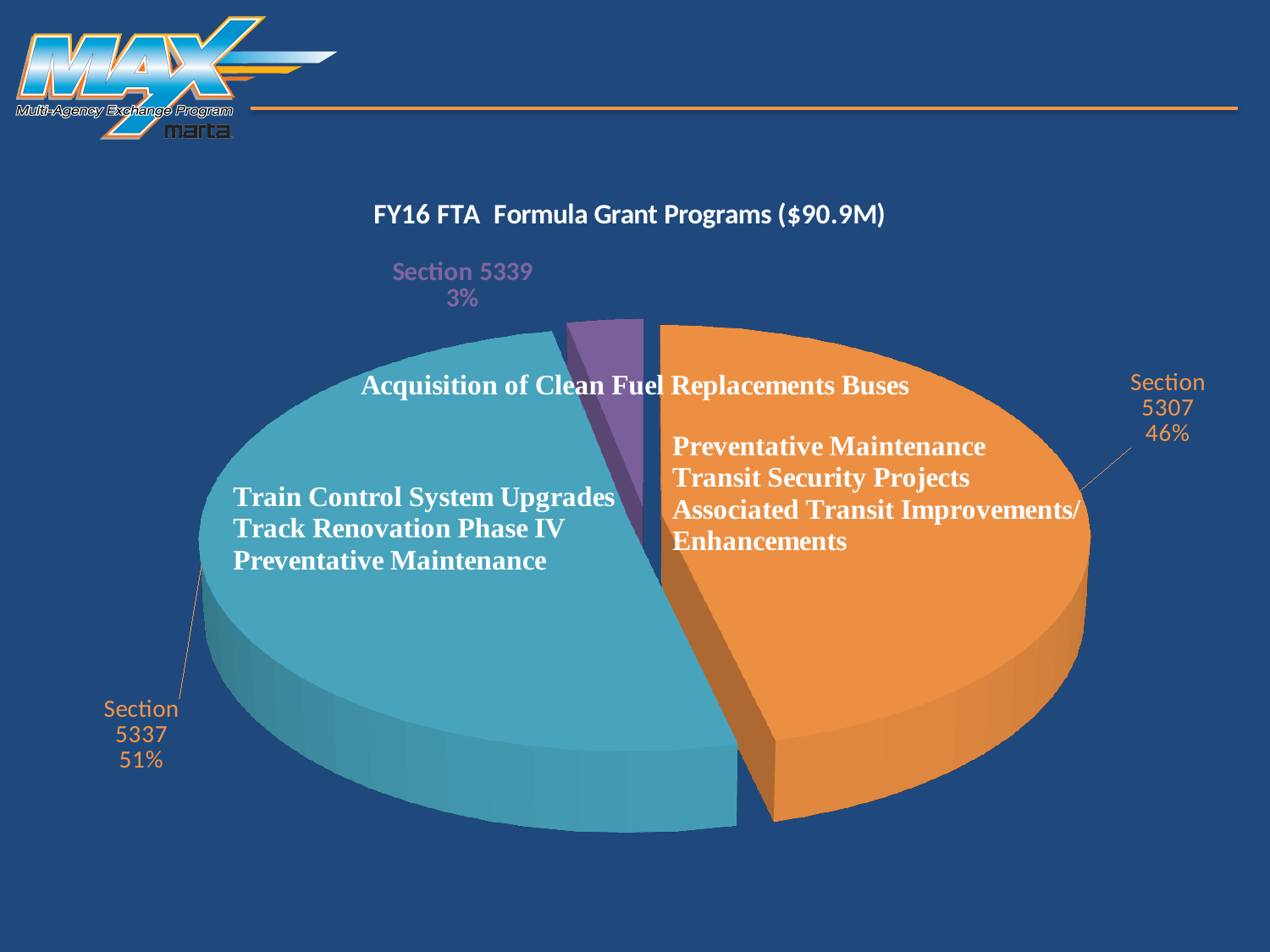
What is the difference in percentage points between Section 5307 and Section 5339? 43 What share of the pie does Section 5337 represent? 51% How many slices does the pie chart have? 3 Which section has the largest share of the pie? Section 5337 What is the title of the chart? FY16 FTA Formula Grant Programs ($90.9M) Which is larger, the share for Section 5307 or the share for Section 5339? Section 5307 What share of the pie does Section 5339 represent? 3% What colour is the Section 5307 slice? Orange What is the difference in percentage points between Section 5337 and Section 5307? 5 What kind of chart is shown on the slide? Pie chart Which section has the smallest share of the pie? Section 5339 What share of the pie does Section 5307 represent? 46%